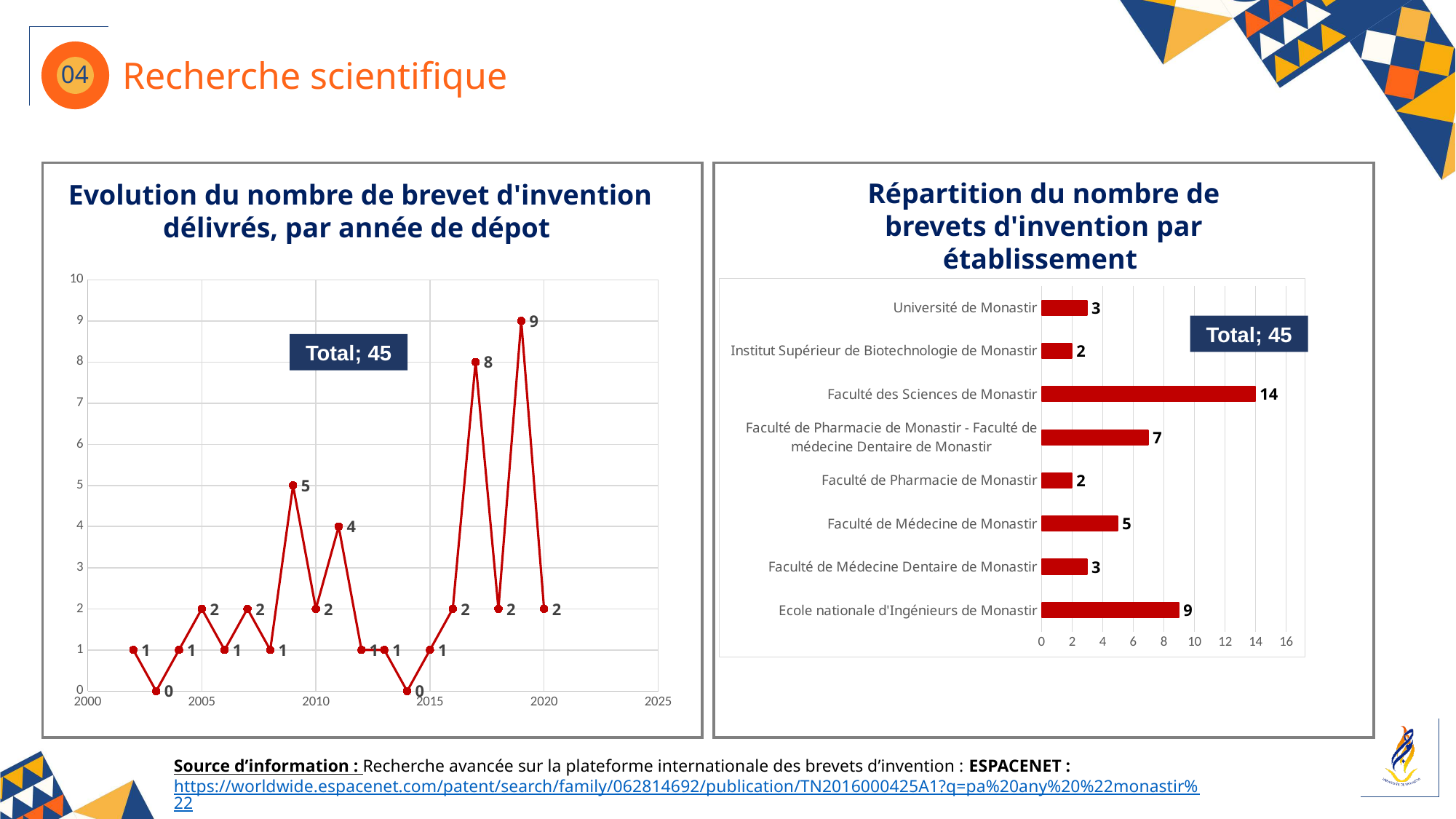
In the chart 'Répartition du nombre de brevets d'invention par établissement', what is the value for Ecole nationale d'Ingénieurs de Monastir? 9 In the chart 'Evolution du nombre de brevet d'invention délivrés, par année de dépot', what is the highest value plotted? 9 What kind of chart is 'Répartition du nombre de brevets d'invention par établissement'? Bar chart In the chart 'Répartition du nombre de brevets d'invention par établissement', what is the value for Faculté des Sciences de Monastir? 14 What kind of chart is 'Evolution du nombre de brevet d'invention délivrés, par année de dépot'? Line chart In the chart 'Evolution du nombre de brevet d'invention délivrés, par année de dépot', what is the lowest value plotted? 0 What total is shown in the label on the chart 'Evolution du nombre de brevet d'invention délivrés, par année de dépot'? 45 In the chart 'Répartition du nombre de brevets d'invention par établissement', what is the difference between Faculté des Sciences de Monastir and Ecole nationale d'Ingénieurs de Monastir? 5 In the chart 'Répartition du nombre de brevets d'invention par établissement', which establishment has the highest number of patents? Faculté des Sciences de Monastir In the chart 'Répartition du nombre de brevets d'invention par établissement', what is the value for Faculté de Médecine de Monastir? 5 How many establishments are shown in the chart 'Répartition du nombre de brevets d'invention par établissement'? 8 In the chart 'Répartition du nombre de brevets d'invention par établissement', which is larger: Faculté de Médecine de Monastir or Faculté de Médecine Dentaire de Monastir? Faculté de Médecine de Monastir